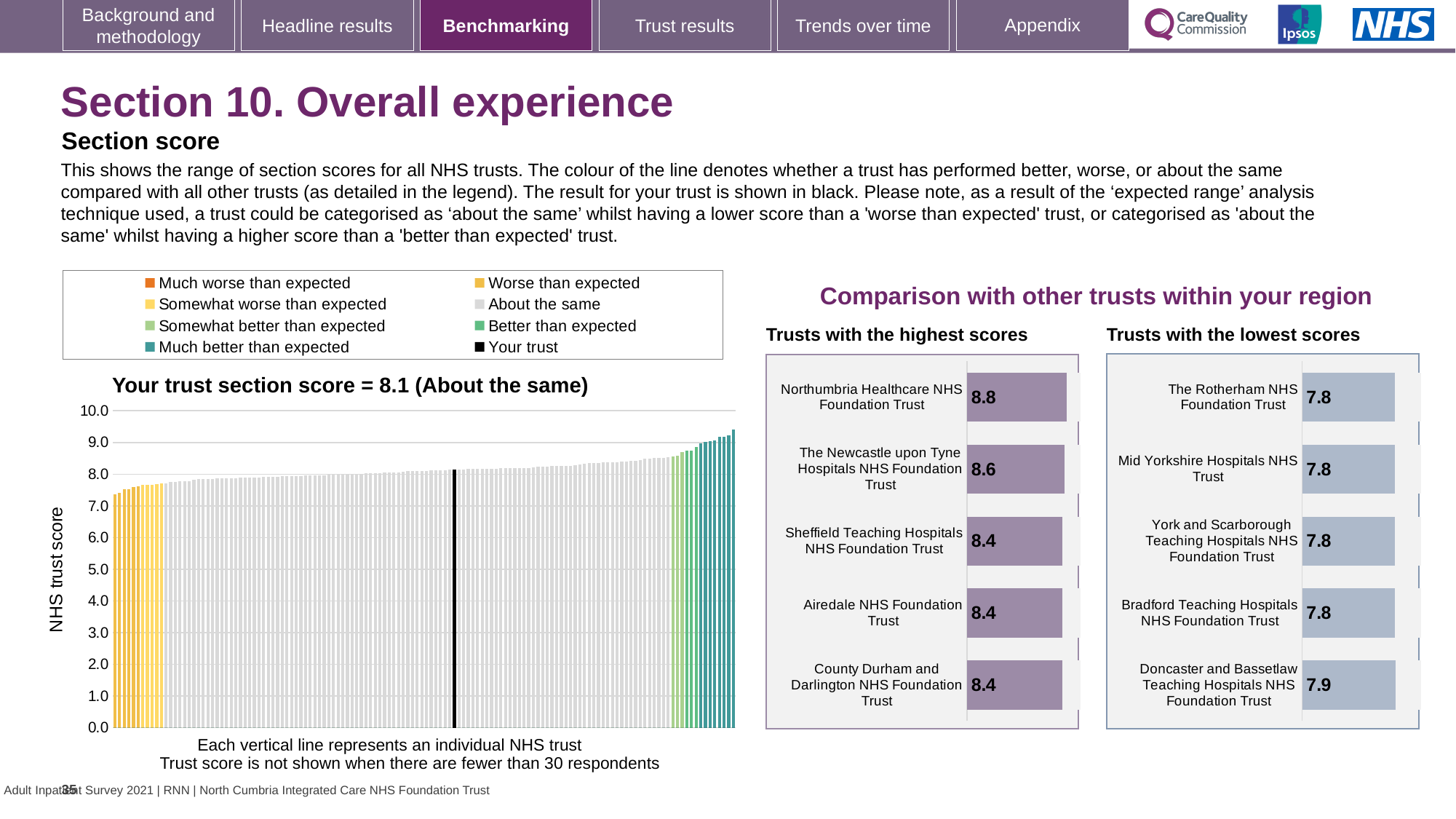
On the 'Trusts with the highest scores' chart, what is the score for Northumbria Healthcare NHS Foundation Trust? 8.8 On the 'Your trust section score' chart, is the value of the rightmost bar greater or less than 9.0? greater On the 'Trusts with the lowest scores' chart, what is the score for Doncaster and Bassetlaw Teaching Hospitals NHS Foundation Trust? 7.9 Which is larger: the score for Northumbria Healthcare NHS Foundation Trust on the 'Trusts with the highest scores' chart or the score for Doncaster and Bassetlaw Teaching Hospitals NHS Foundation Trust on the 'Trusts with the lowest scores' chart? Northumbria Healthcare NHS Foundation Trust What kind of chart is the 'Your trust section score' chart? bar chart On the 'Trusts with the highest scores' chart, what is the difference between the scores of Northumbria Healthcare NHS Foundation Trust and The Newcastle upon Tyne Hospitals NHS Foundation Trust? 0.2 On the 'Your trust section score' chart, what is the section score for your trust? 8.1 How many entries does the legend above the 'Your trust section score' chart list? 8 On the 'Your trust section score' chart, is the value of the leftmost bar greater or less than 8.0? less On the 'Your trust section score' chart, do the bars rise or fall from left to right? rise How many trusts are shown on the 'Trusts with the lowest scores' chart? 5 On the 'Trusts with the highest scores' chart, which trust has the highest score? Northumbria Healthcare NHS Foundation Trust